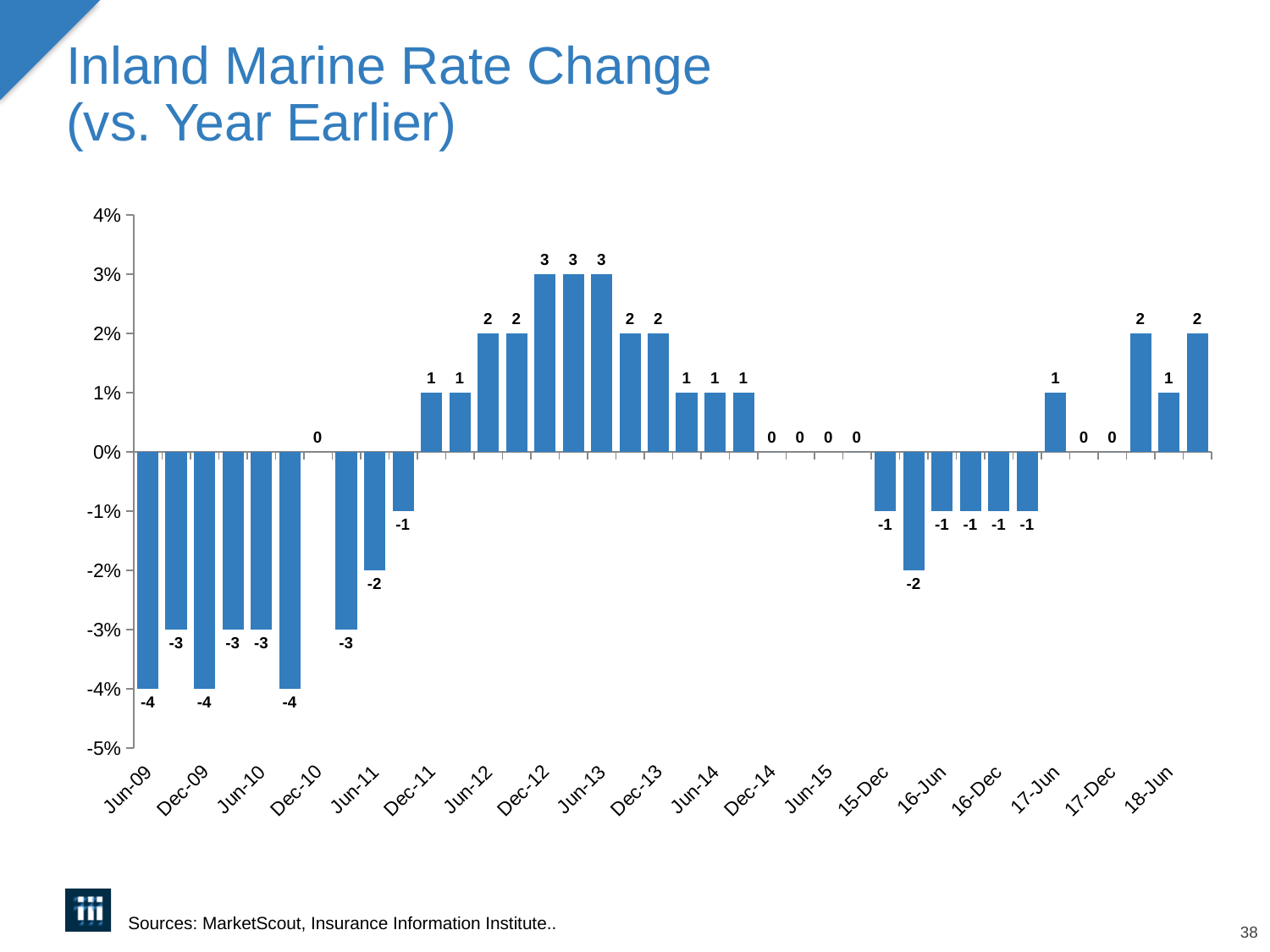
What is the difference between the value for Dec-12 and the value for Jun-11? 5 What is the inland marine rate change for Dec-12? 3 What is the lowest value shown on the chart? -4 What is the inland marine rate change for 17-Jun? 1 What is the title of the chart? Inland Marine Rate Change (vs. Year Earlier) Which is larger, the value for Dec-13 or the value for 16-Jun? Dec-13 What is the highest value shown on the chart? 3 What is the inland marine rate change for Jun-11? -2 What type of chart is shown on the slide? bar chart Do the values rise or fall from Jun-09 to Dec-12? rise What is the inland marine rate change for Jun-09? -4 How many bars are plotted on the chart? 38